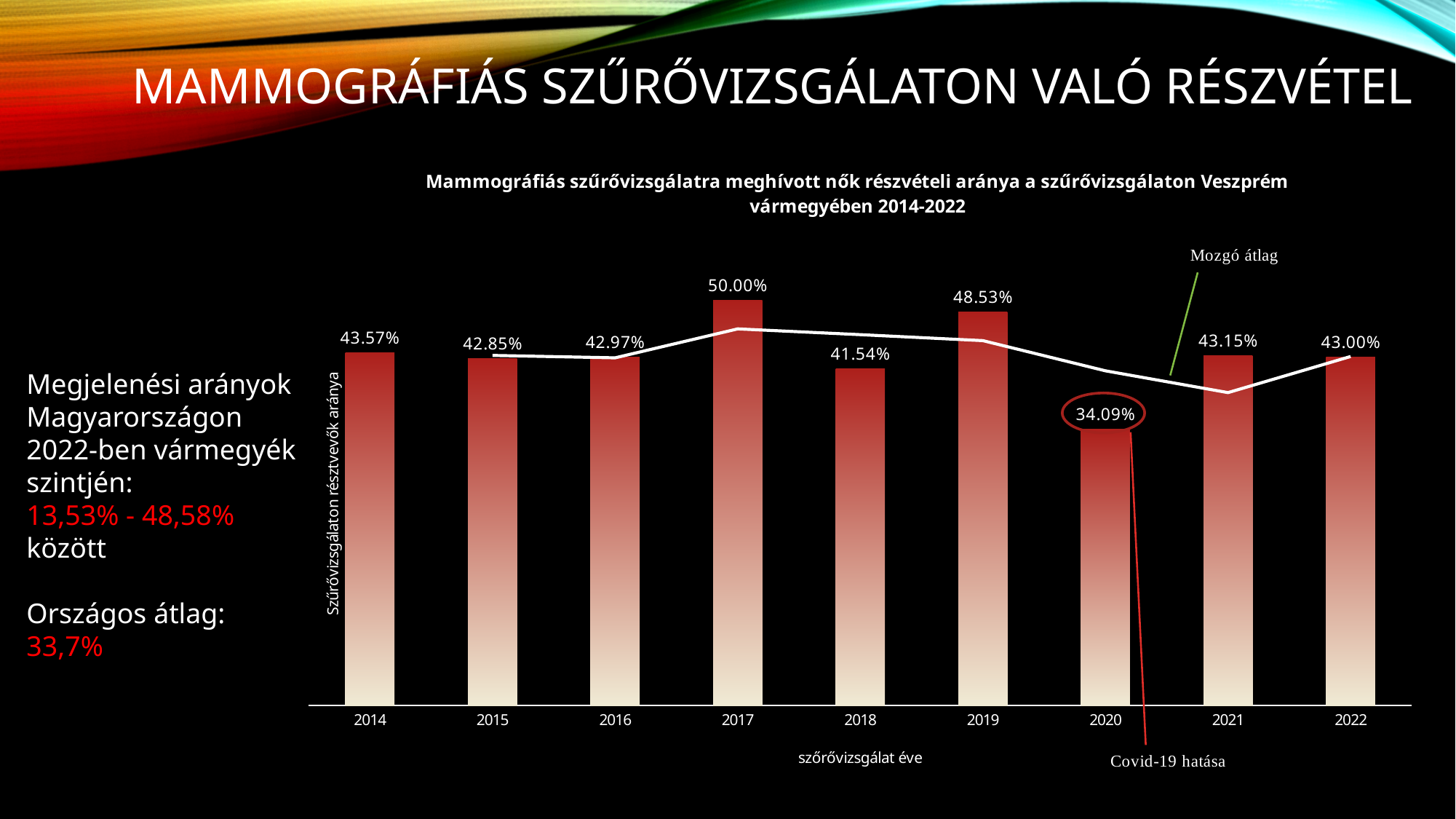
How many years are shown on the x axis of the chart? 9 Which year has the highest participation rate? 2017 What is the difference between the participation rates for 2019 and 2018? 6.99% What is the participation rate for 2017? 50.00% What is the participation rate for 2020? 34.09% Which year has a higher participation rate, 2019 or 2021? 2019 What is the participation rate for 2014? 43.57% What does the white line on the chart represent, according to the annotation? Mozgó átlag What is the participation rate for 2022? 43.00% What is the difference between the participation rates for 2017 and 2020? 15.91% What kind of chart is shown on the slide? Bar chart Which year has the lowest participation rate? 2020